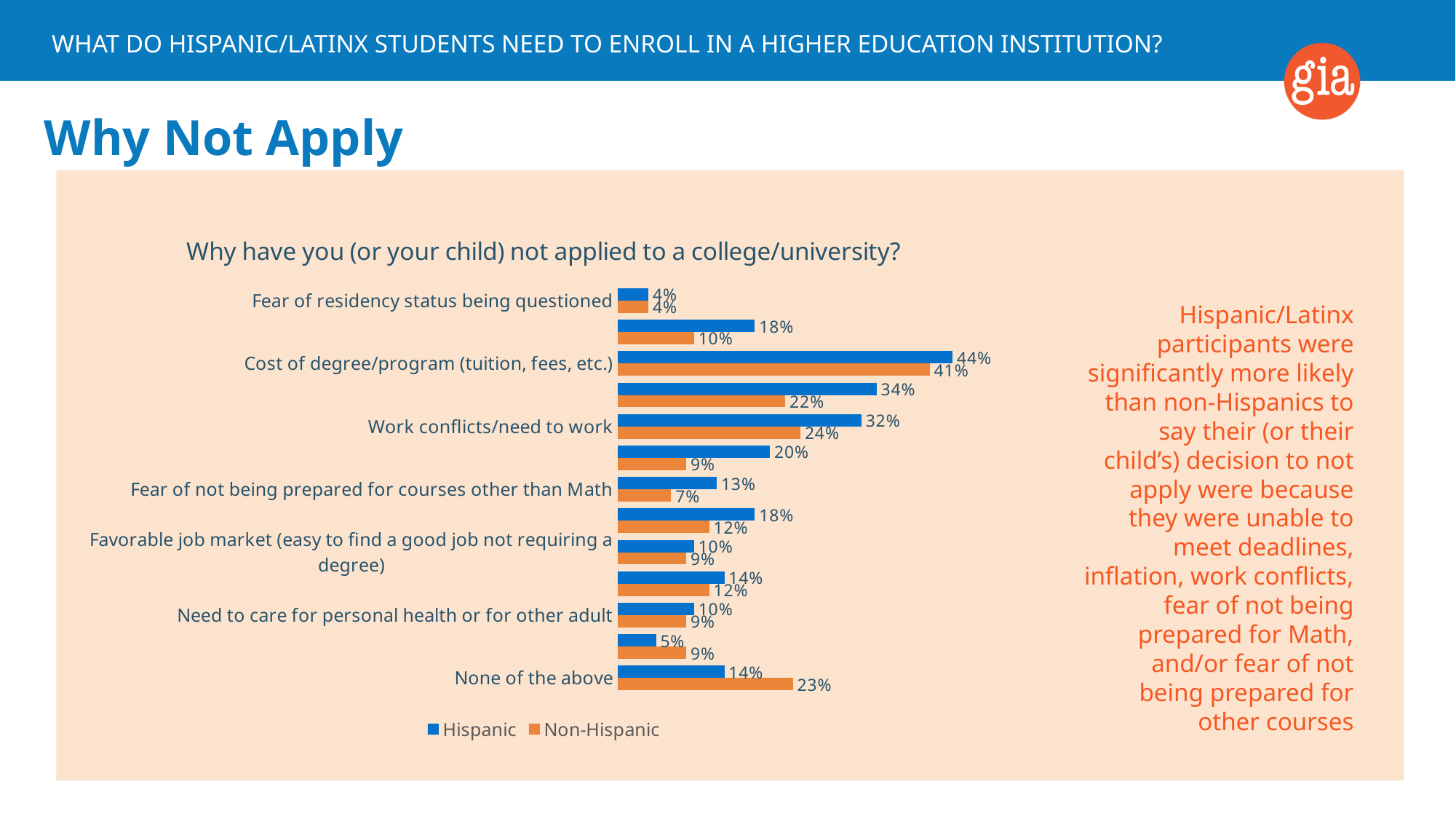
What is the Non-Hispanic value for 'Work conflicts/need to work'? 24% What is the Non-Hispanic value for 'None of the above'? 23% For 'None of the above', which series has the larger value, Hispanic or Non-Hispanic? Non-Hispanic What is the Hispanic value for 'Cost of degree/program (tuition, fees, etc.)'? 44% How many series does the legend list? 2 What is the difference between the Non-Hispanic and Hispanic values for 'None of the above'? 9% Which labeled reason has the highest Hispanic value? Cost of degree/program (tuition, fees, etc.) What kind of chart is shown on the slide? Bar chart Which labeled reason has the lowest Non-Hispanic value? Fear of residency status being questioned For 'Fear of not being prepared for courses other than Math', which series has the larger value, Hispanic or Non-Hispanic? Hispanic What is the Hispanic value for 'Fear of not being prepared for courses other than Math'? 13% What is the difference between the Hispanic and Non-Hispanic values for 'Work conflicts/need to work'? 8%